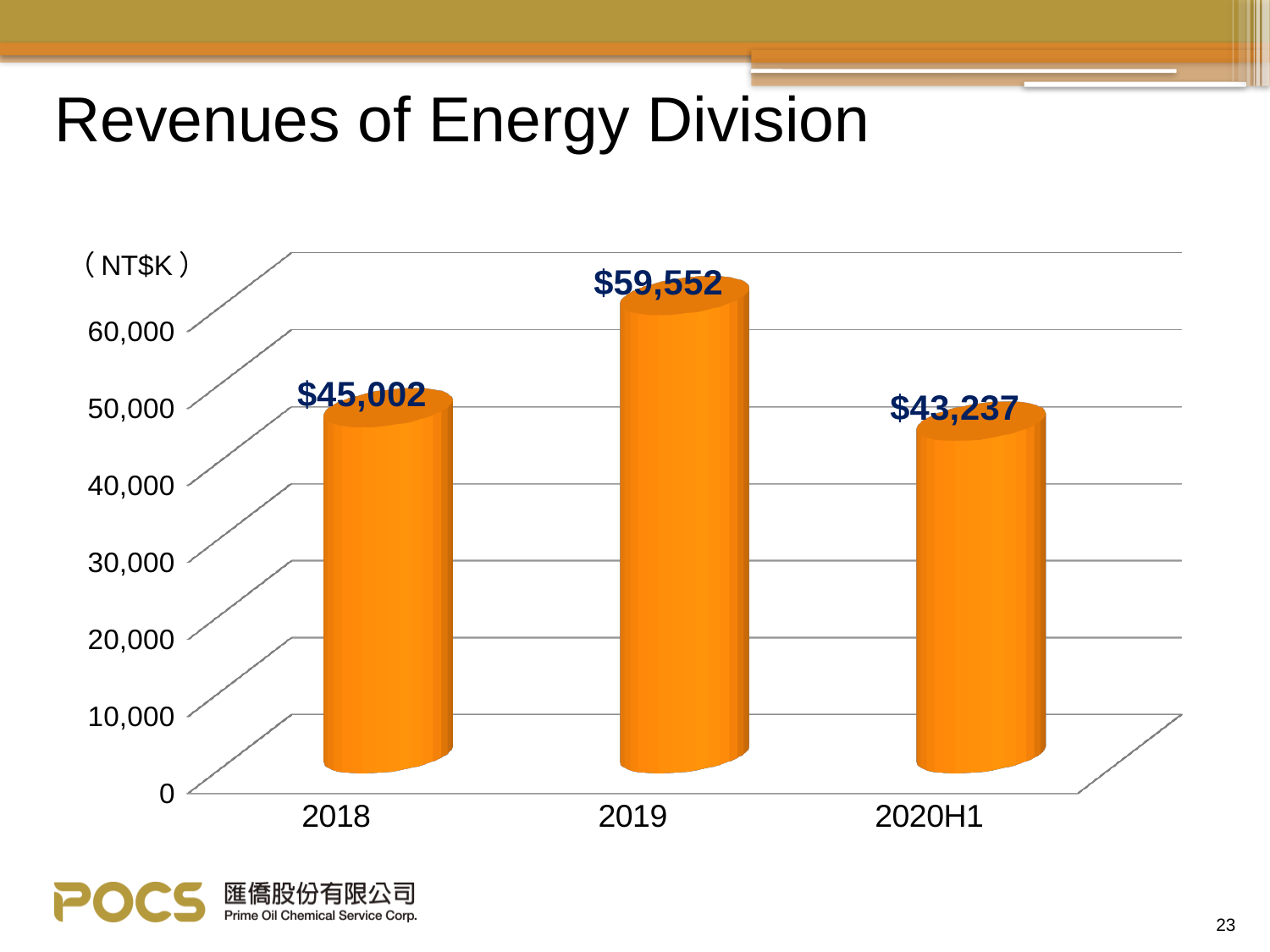
What is the revenue of the Energy Division for 2018? $45,002 What is the revenue of the Energy Division for 2019? $59,552 Which period has the highest revenue? 2019 Which period has the lowest revenue? 2020H1 How many periods are shown on the x axis? 3 Which is larger, the revenue for 2018 or for 2020H1? 2018 What is the difference between the 2019 and 2018 revenues? $14,550 What kind of chart is shown on the slide? Bar chart What is the difference between the 2018 and 2020H1 revenues? $1,765 Is the revenue for 2019 greater or less than 50,000? greater What is the revenue of the Energy Division for 2020H1? $43,237 What unit is indicated for the values on the chart? NT$K